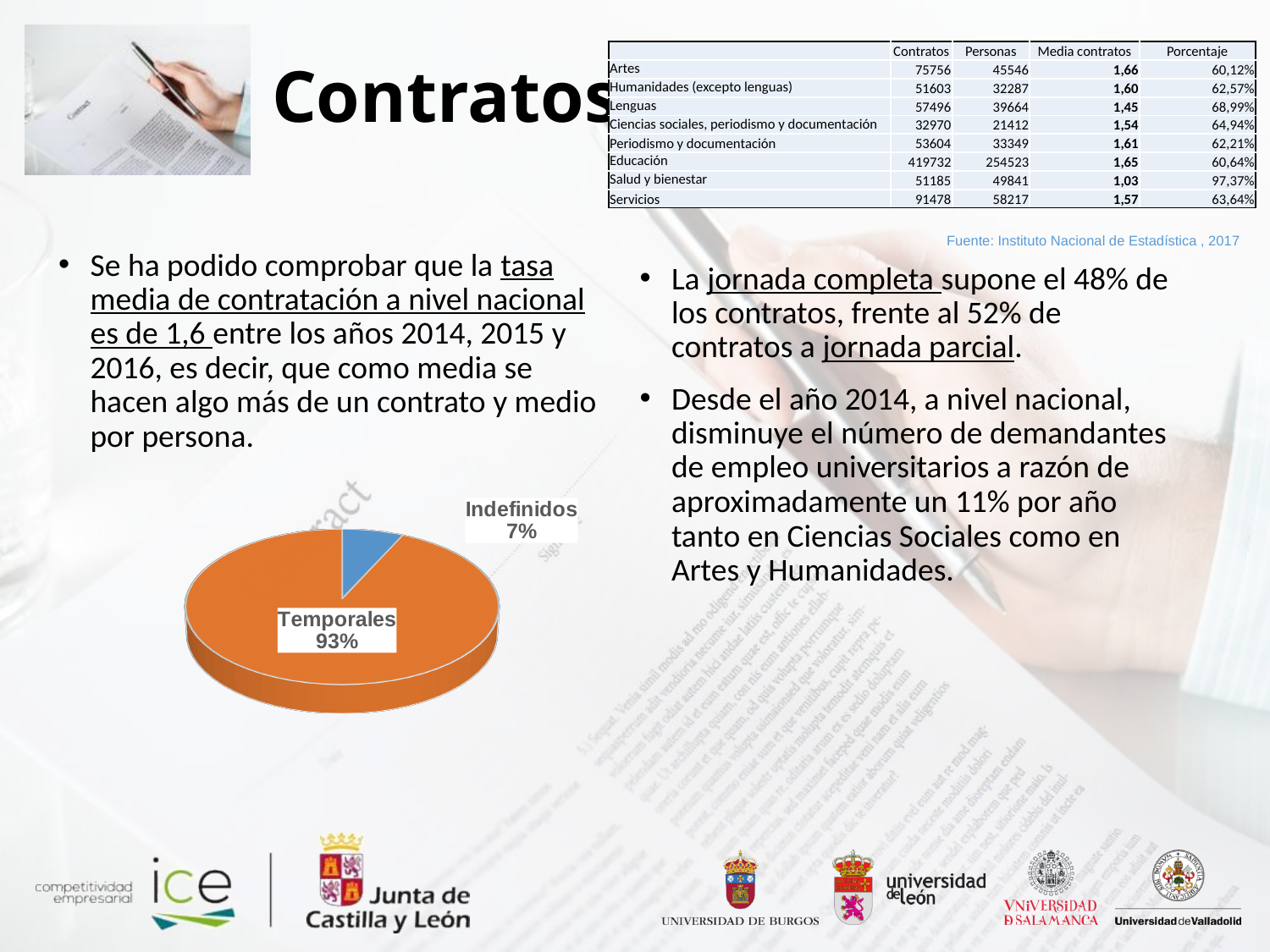
What colour is the Indefinidos slice in the pie chart? blue Which slice of the pie chart is the largest? Temporales What colour is the Temporales slice in the pie chart? orange How many slices does the pie chart have? 2 Which slice of the pie chart is the smallest? Indefinidos What is the difference in percentage points between the Temporales and Indefinidos slices of the pie chart? 86 What kind of chart is shown on the slide? pie chart What share of the pie chart is Temporales? 93% What share of the pie chart is Indefinidos? 7% In the pie chart, which is larger, Temporales or Indefinidos? Temporales